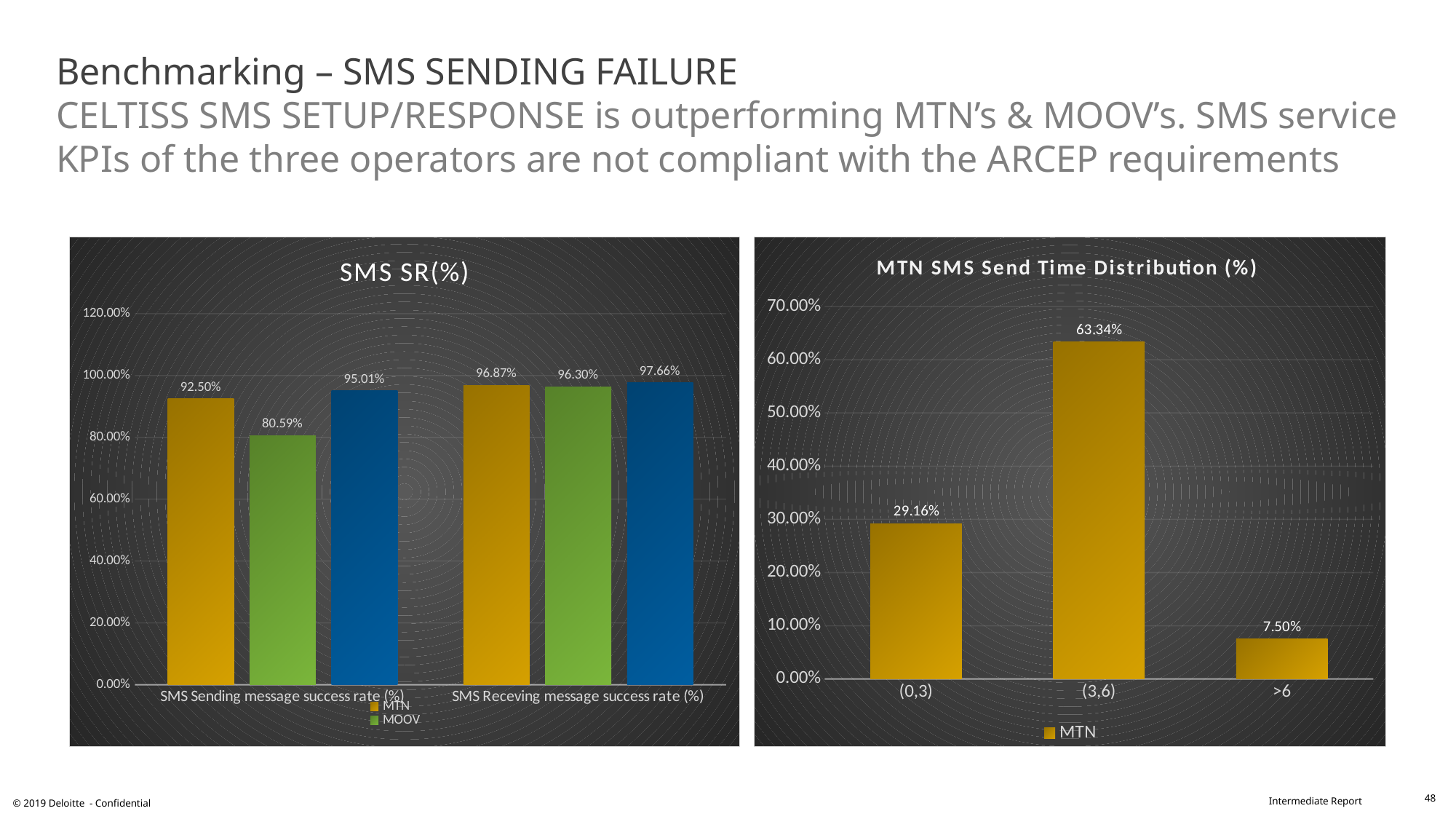
In the MTN SMS Send Time Distribution (%) chart, which category has the lowest value? >6 In the SMS SR(%) chart, what is the MOOV value for SMS Sending message success rate (%)? 80.59% In the MTN SMS Send Time Distribution (%) chart, how many series does the legend list? 1 In the SMS SR(%) chart, what is the difference between the MTN and MOOV values for SMS Sending message success rate (%)? 11.91% In the SMS SR(%) chart, what is the MTN value for SMS Receving message success rate (%)? 96.87% In the SMS SR(%) chart, how many categories are shown on the x axis? 2 What kind of chart is the SMS SR(%) chart? Bar chart In the SMS SR(%) chart, which is larger for SMS Sending message success rate (%): MTN or MOOV? MTN In the SMS SR(%) chart, what is the MTN value for SMS Sending message success rate (%)? 92.50% In the MTN SMS Send Time Distribution (%) chart, what is the value for (3,6)? 63.34% In the MTN SMS Send Time Distribution (%) chart, what is the difference between the (3,6) and (0,3) values? 34.18% In the SMS SR(%) chart, what is the MOOV value for SMS Receving message success rate (%)? 96.30%